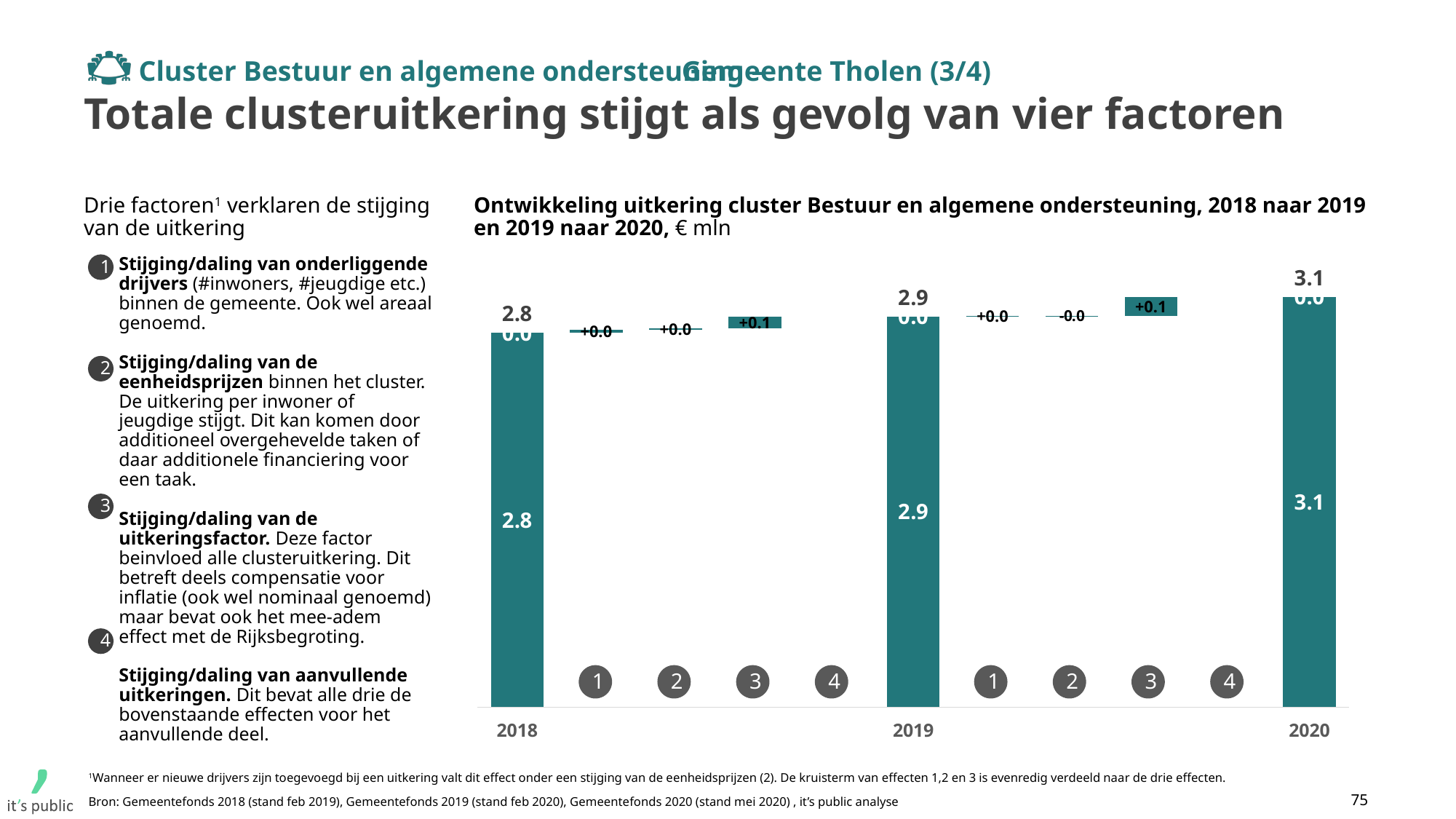
In what unit are the values in the chart expressed? € mln Is the total for 2019 larger or smaller than the total for 2020? smaller What is the value of factor 3 (uitkeringsfactor) in the step from 2019 to 2020? +0.1 Which year has the lowest total uitkering in the chart? 2018 Which year has the highest total uitkering in the chart? 2020 What is the total uitkering value shown for 2018? 2.8 What is the value of factor 2 in the step from 2019 to 2020? -0.0 What is the total uitkering value shown for 2019? 2.9 What is the value of factor 3 (uitkeringsfactor) in the step from 2018 to 2019? +0.1 What is the total uitkering value shown for 2020? 3.1 What is the difference between the 2020 total and the 2018 total? 0.3 Do the total uitkering values rise or fall from 2018 to 2020? rise